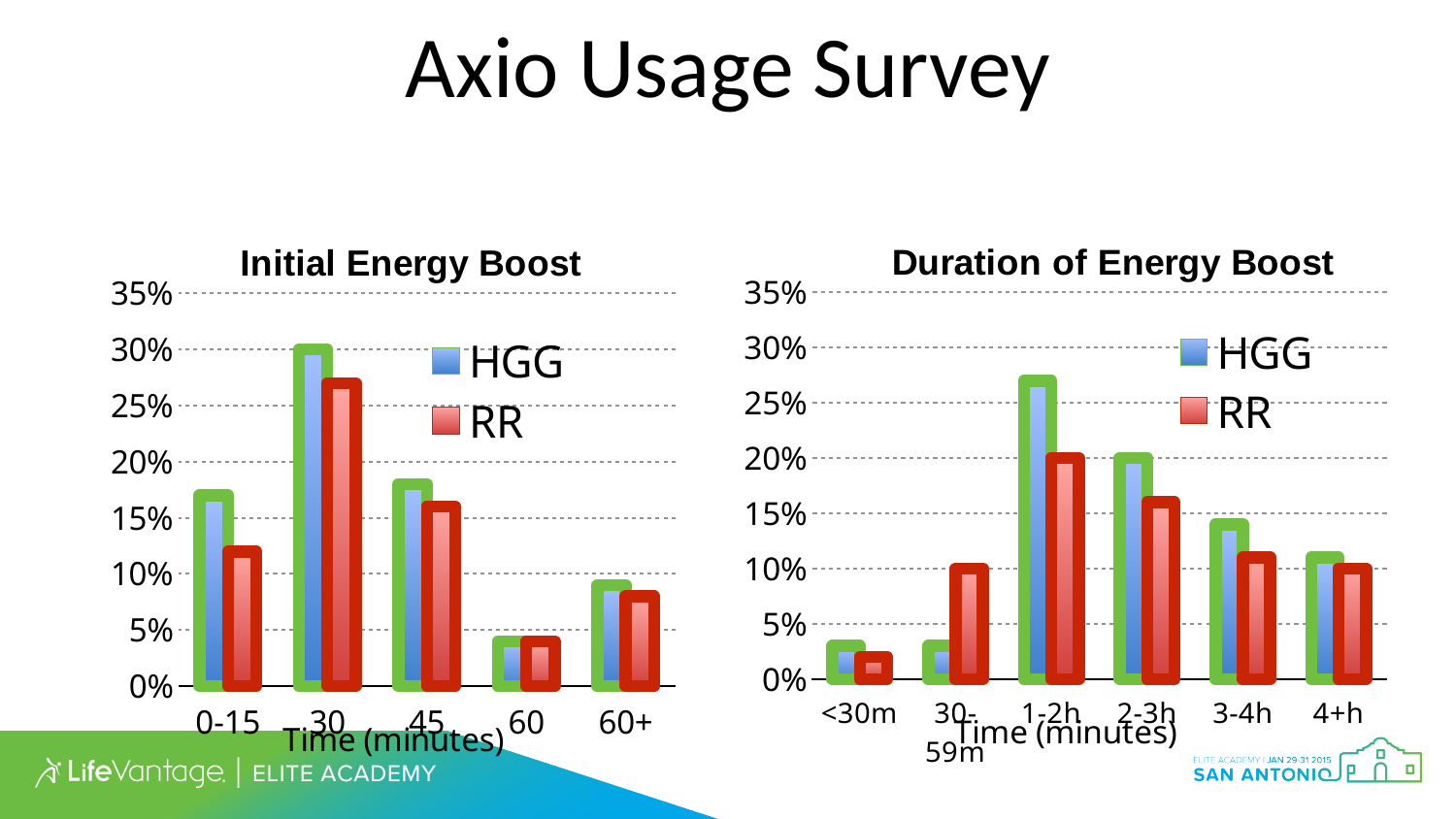
What kind of chart is the Initial Energy Boost chart? bar chart In the Initial Energy Boost chart, which series has the larger value for 0-15, HGG or RR? HGG In the Duration of Energy Boost chart, which category has the lowest RR value? <30m What are the two series named in the legend of the Initial Energy Boost chart? HGG and RR In the Initial Energy Boost chart, is the HGG value for 30 greater or less than 25%? greater How many categories are shown on the x axis of the Duration of Energy Boost chart? 6 In the Duration of Energy Boost chart, which category has the highest HGG value? 1-2h How many series does the legend of the Duration of Energy Boost chart list? 2 In the Duration of Energy Boost chart, which series has the larger value for 30-59m, HGG or RR? RR How many time categories are shown on the x axis of the Initial Energy Boost chart? 5 In the Duration of Energy Boost chart, is the RR value for 30-59m greater or less than 5%? greater In the Initial Energy Boost chart, which time category has the highest HGG value? 30